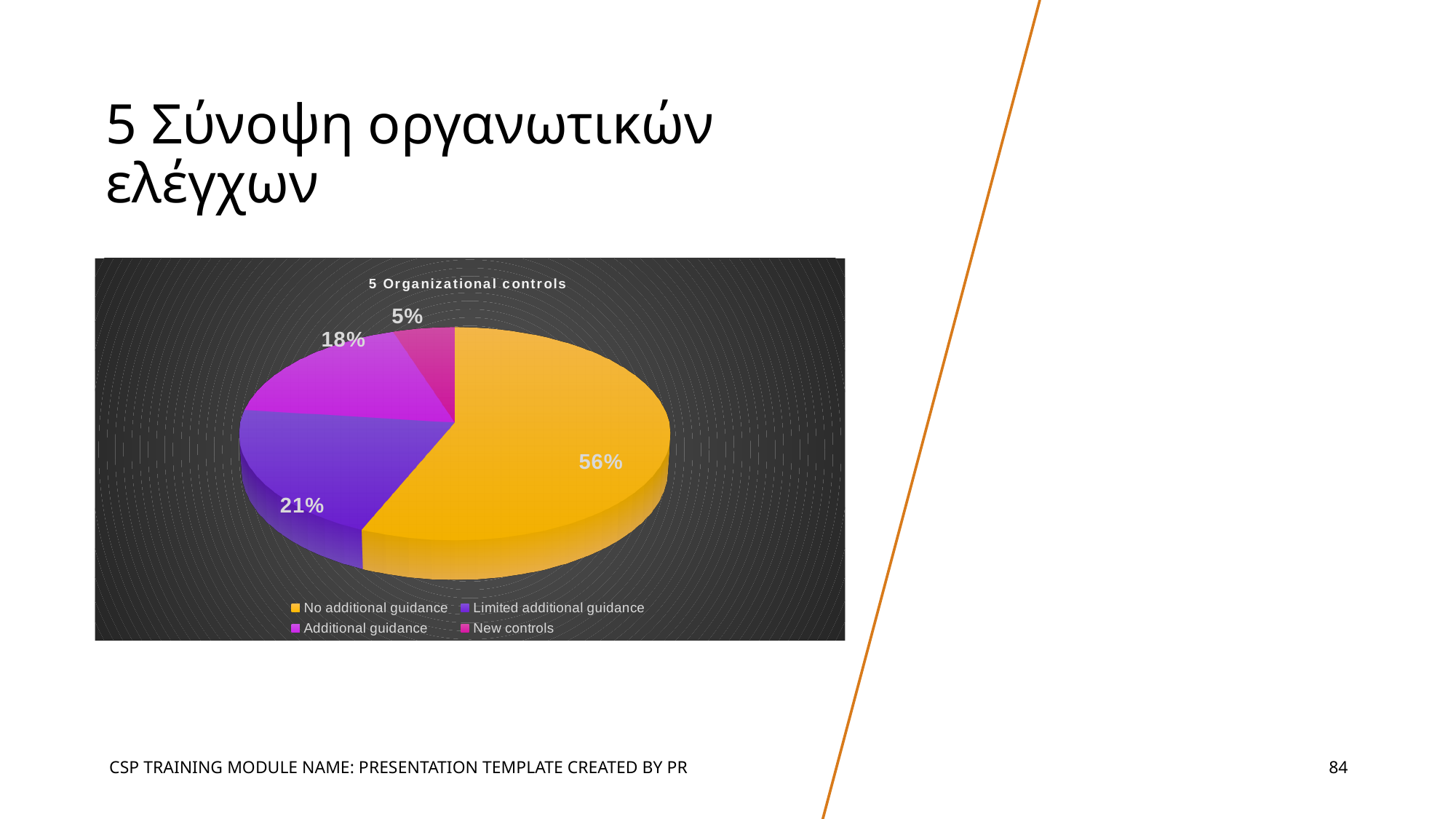
What is the difference in percentage points between 'No additional guidance' and 'Limited additional guidance'? 35 What colour is the 'No additional guidance' slice? Orange What share of the pie is 'No additional guidance'? 56% Which is larger, 'Limited additional guidance' or 'Additional guidance'? Limited additional guidance What share of the pie is 'New controls'? 5% Which category has the largest slice of the pie? No additional guidance What kind of chart is shown on the slide? Pie chart Which category has the smallest slice of the pie? New controls What share of the pie is 'Additional guidance'? 18% How many categories does the pie chart show? 4 What is the title of the chart? 5 Organizational controls